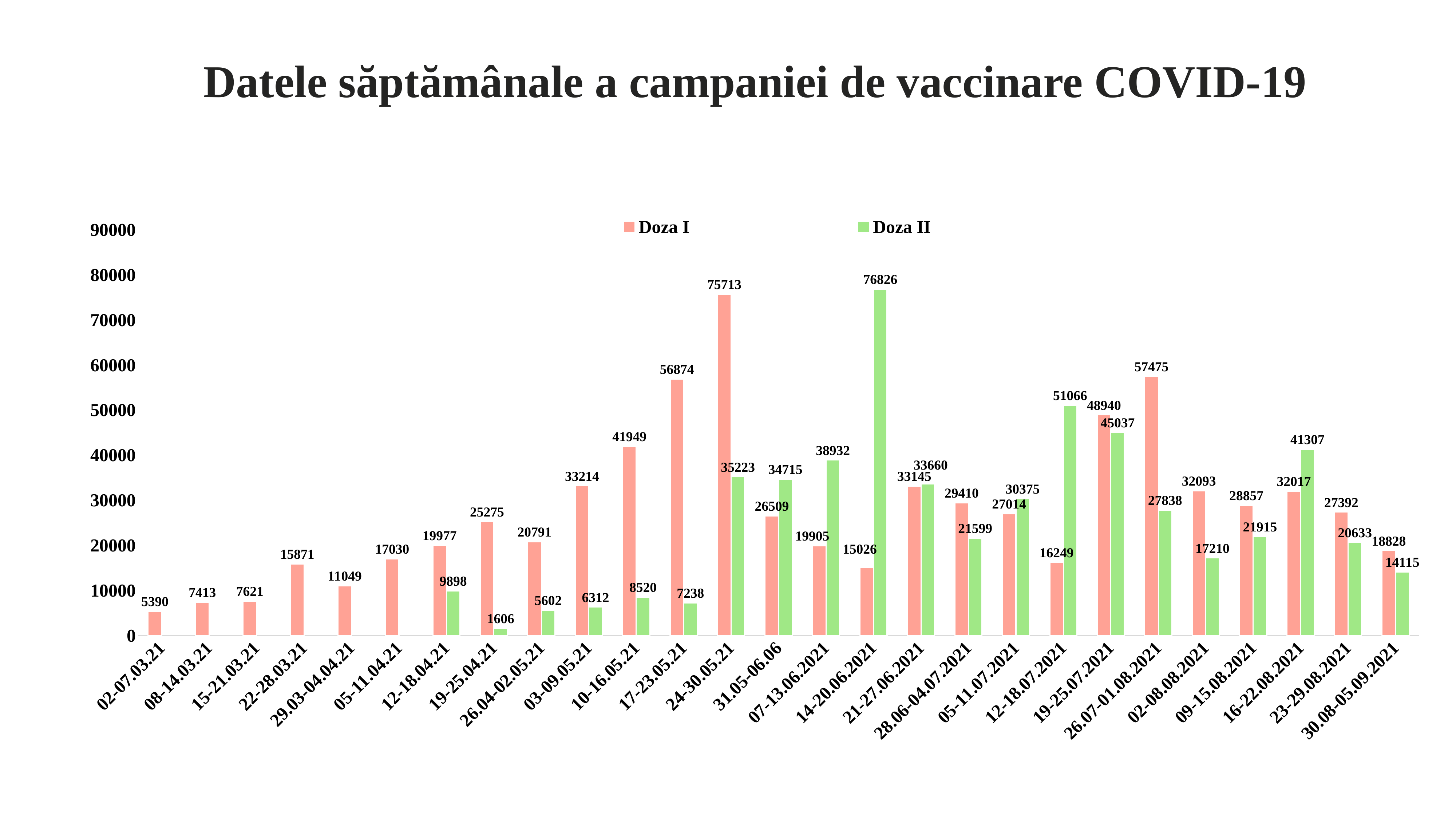
What type of chart is shown on the slide? bar chart What is the Doza I value for the week 24-30.05.21? 75713 What is the Doza II value for the week 14-20.06.2021? 76826 Do the Doza I values rise or fall from 02-07.03.21 to 24-30.05.21? rise How many series does the legend list? 2 How many weekly periods are shown on the x axis? 27 In the week 19-25.07.2021, which is larger, Doza I or Doza II? Doza I Is the Doza I value for the week 17-23.05.21 greater or less than 50000? greater What is the title of the chart? Datele săptămânale a campaniei de vaccinare COVID-19 Which week has the lowest Doza I value? 02-07.03.21 What is the difference between Doza I and Doza II in the week 24-30.05.21? 40490 Which week has the highest Doza II value? 14-20.06.2021